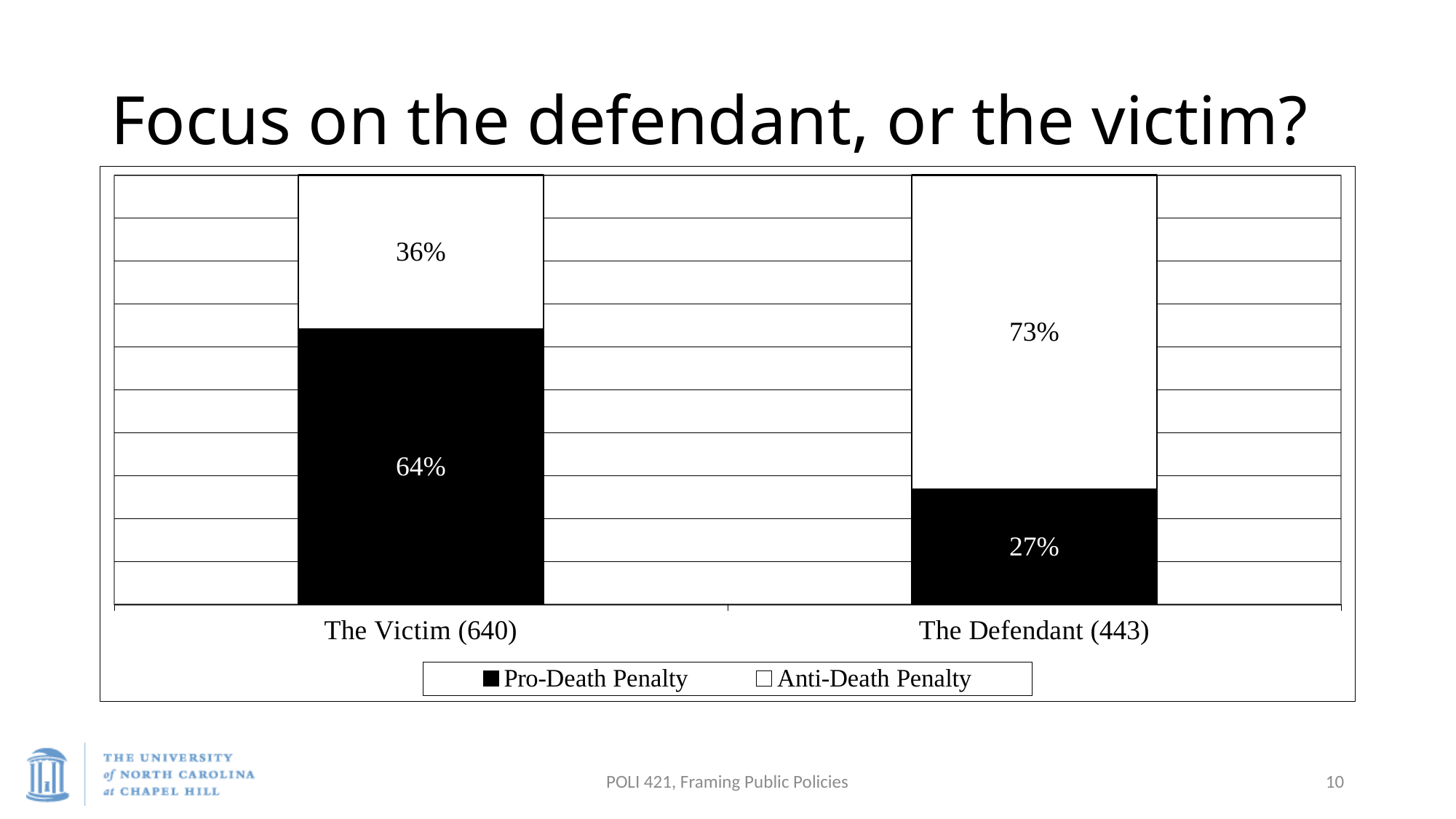
How many categories are shown on the x axis? 2 What kind of chart is shown on the slide? Stacked bar chart Which category has the higher Pro-Death Penalty value? The Victim (640) Which series is shown in black in the legend? Pro-Death Penalty What is the Pro-Death Penalty value for The Victim (640)? 64% Which category has the lower Anti-Death Penalty value? The Victim (640) What is the difference between the Pro-Death Penalty values for The Victim (640) and The Defendant (443)? 37% What is the Anti-Death Penalty value for The Victim (640)? 36% Is the Anti-Death Penalty value larger for The Victim (640) or The Defendant (443)? The Defendant (443) What is the Pro-Death Penalty value for The Defendant (443)? 27% What is the Anti-Death Penalty value for The Defendant (443)? 73% How many series does the legend list? 2